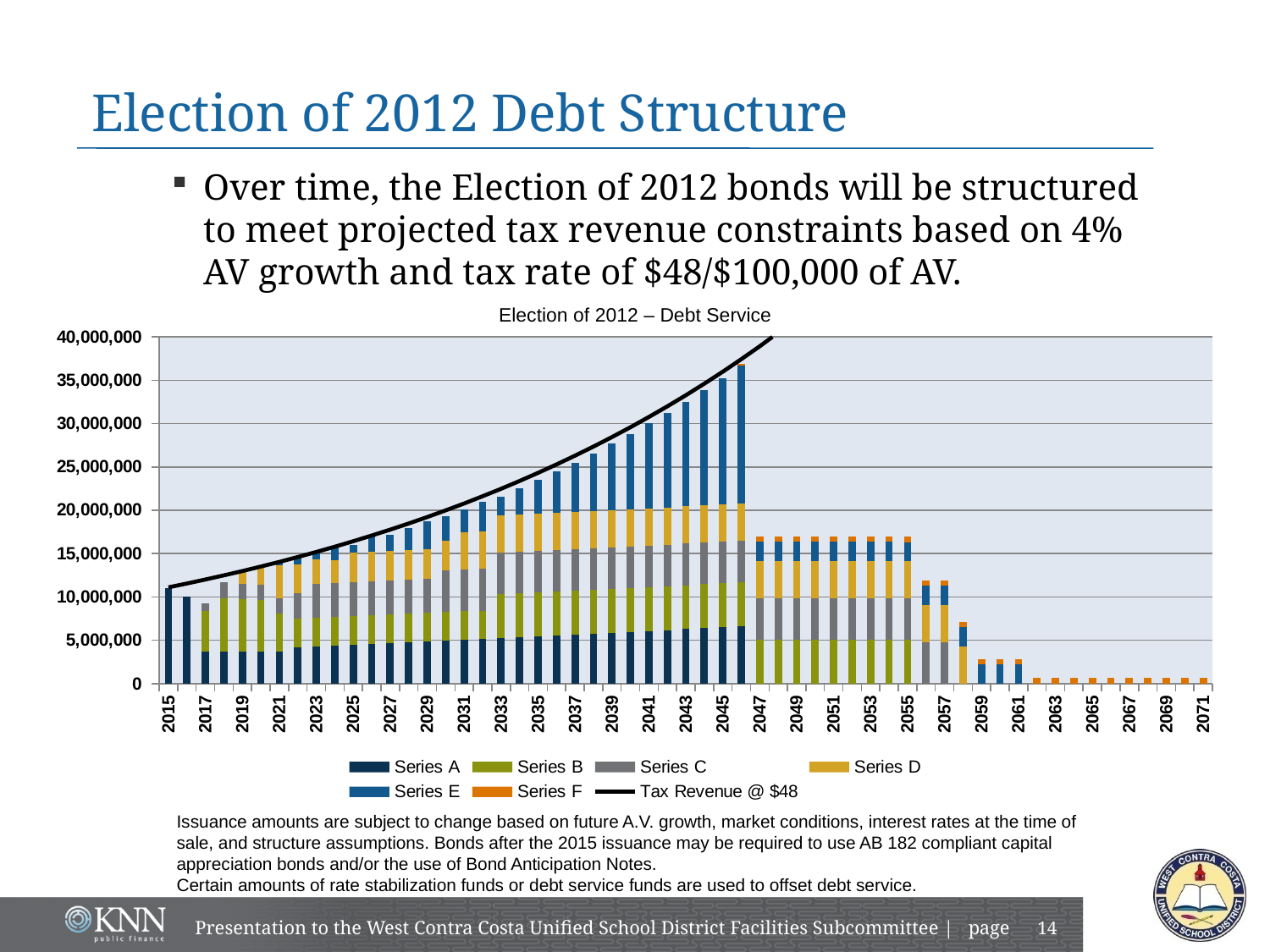
Which year has the taller total debt service bar, 2045 or 2047? 2045 What is the title of the chart? Election of 2012 – Debt Service Is the total debt service bar for 2059 greater or less than 5,000,000? less Is the total debt service bar for 2035 greater or less than 20,000,000? greater Does the Tax Revenue @ $48 line rise or fall from 2015 to 2046? rise Is the total debt service bar for 2017 greater or less than 10,000,000? less How many entries does the chart legend list? 7 What is the name of the line series plotted over the bars? Tax Revenue @ $48 What kind of chart is shown on the slide? Stacked bar chart with a line Which year has the taller total debt service bar, 2055 or 2057? 2055